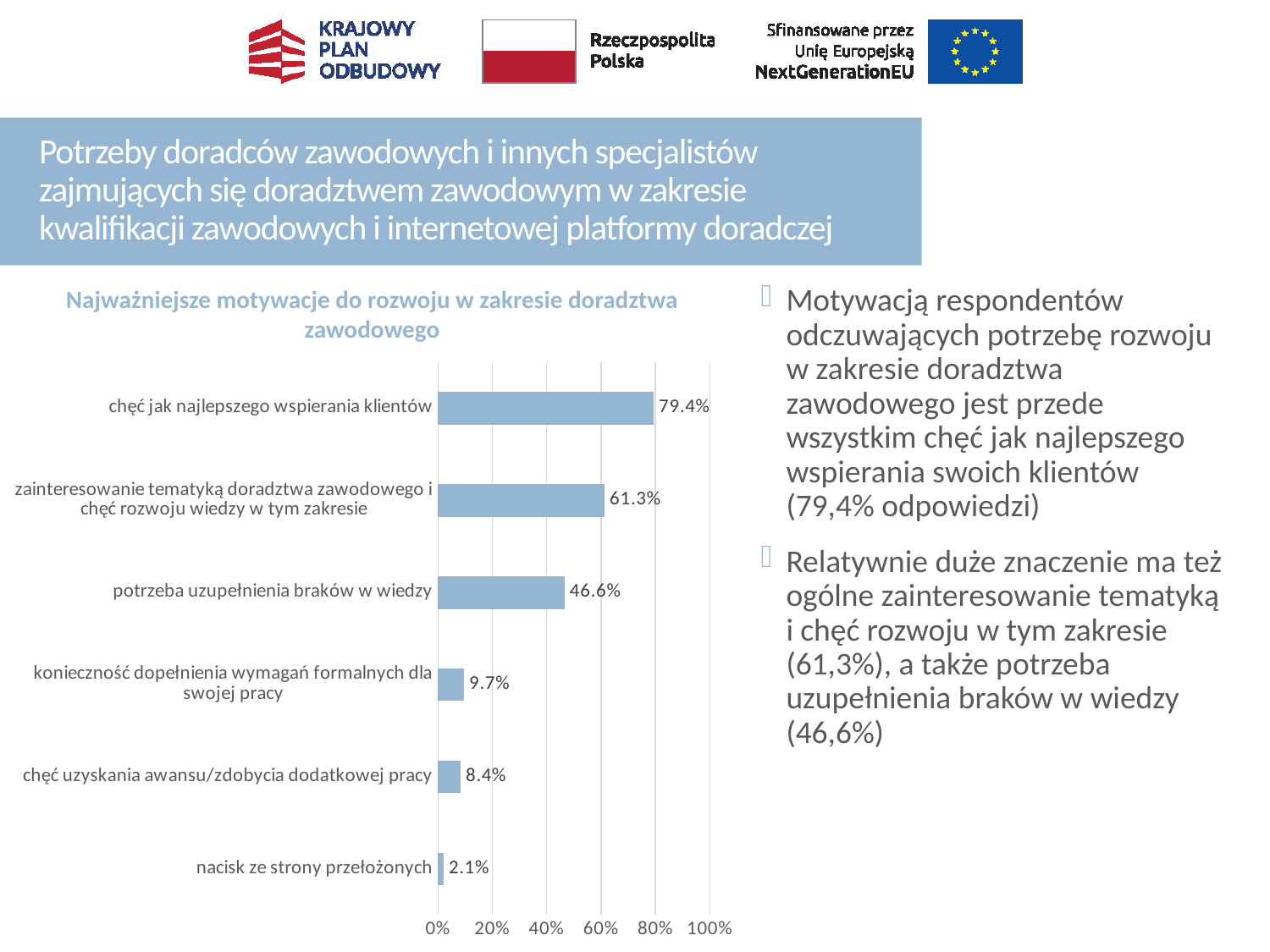
Which category has the highest value? chęć jak najlepszego wspierania klientów What is the value for "nacisk ze strony przełożonych"? 2.1% What kind of chart is shown on the slide? bar chart How many categories are shown in the chart? 6 What is the value for "chęć uzyskania awansu/zdobycia dodatkowej pracy"? 8.4% What is the difference between the values for "chęć jak najlepszego wspierania klientów" and "zainteresowanie tematyką doradztwa zawodowego i chęć rozwoju wiedzy w tym zakresie"? 18.1 percentage points Is the value for "potrzeba uzupełnienia braków w wiedzy" greater or less than 40%? greater Which category has the lowest value? nacisk ze strony przełożonych What is the value for "chęć jak najlepszego wspierania klientów"? 79.4% Which is larger: the value for "konieczność dopełnienia wymagań formalnych dla swojej pracy" or for "chęć uzyskania awansu/zdobycia dodatkowej pracy"? konieczność dopełnienia wymagań formalnych dla swojej pracy What is the value for "potrzeba uzupełnienia braków w wiedzy"? 46.6% What is the title of the chart? Najważniejsze motywacje do rozwoju w zakresie doradztwa zawodowego